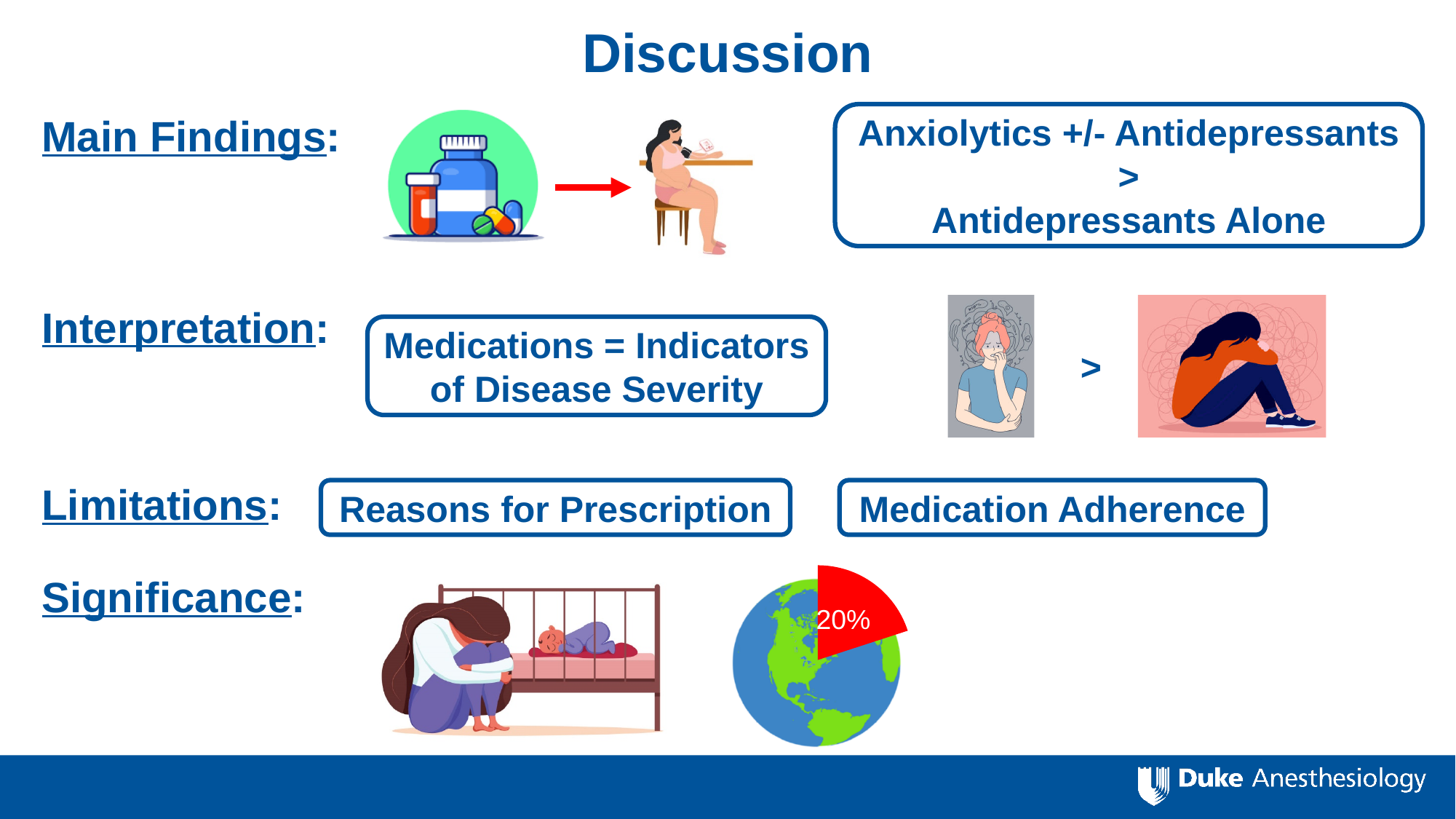
What kind of chart is the red-slice graphic overlaid on the globe in the Significance row? pie chart What percentage is printed on the red slice of the pie graphic in the Significance row? 20% What colour is the labelled slice of the pie graphic in the Significance row? red What share of the whole does the red slice of the pie graphic in the Significance row represent? 20% Is the value shown on the red pie slice in the Significance row greater or less than 50%? less How many labelled slices does the pie graphic in the Significance row show? 1